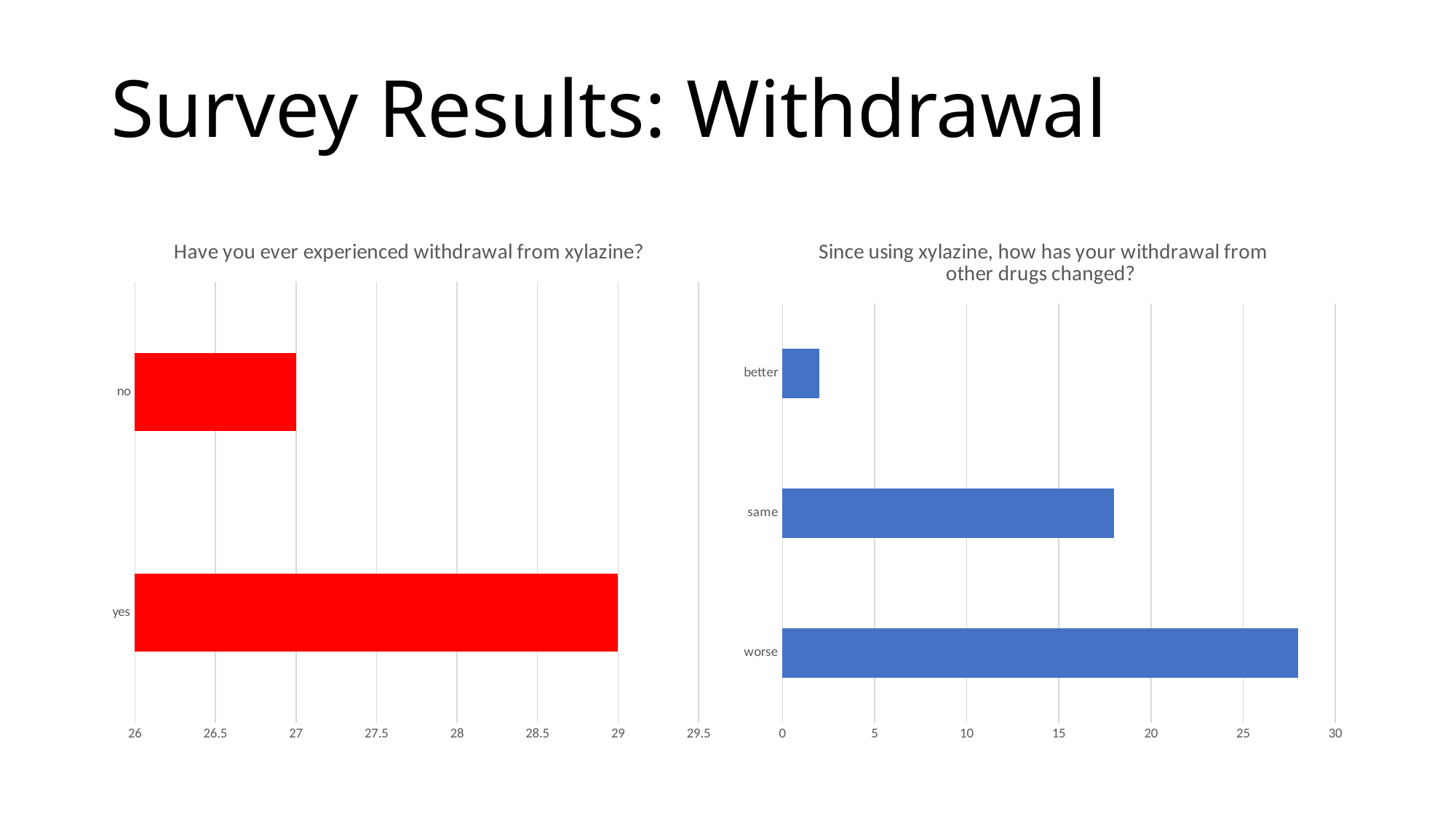
In the chart titled "Have you ever experienced withdrawal from xylazine?", how many categories are shown? 2 In the chart titled "Since using xylazine, how has your withdrawal from other drugs changed?", is the value for "worse" greater or less than 25? greater In the chart titled "Since using xylazine, how has your withdrawal from other drugs changed?", which category has the lowest value? better In the chart titled "Since using xylazine, how has your withdrawal from other drugs changed?", how many categories are shown? 3 In the chart titled "Since using xylazine, how has your withdrawal from other drugs changed?", which is larger, the value for "same" or the value for "better"? same In the chart titled "Have you ever experienced withdrawal from xylazine?", what is the value for "yes"? 29 What kind of chart is the one on the left of the slide? bar chart In the chart titled "Have you ever experienced withdrawal from xylazine?", what is the difference between the values for "yes" and "no"? 2 In the chart titled "Have you ever experienced withdrawal from xylazine?", which category has the higher value? yes In the chart titled "Have you ever experienced withdrawal from xylazine?", what is the value for "no"? 27 In the chart titled "Since using xylazine, how has your withdrawal from other drugs changed?", which category has the highest value? worse In the chart titled "Since using xylazine, how has your withdrawal from other drugs changed?", is the value for "better" greater or less than 5? less